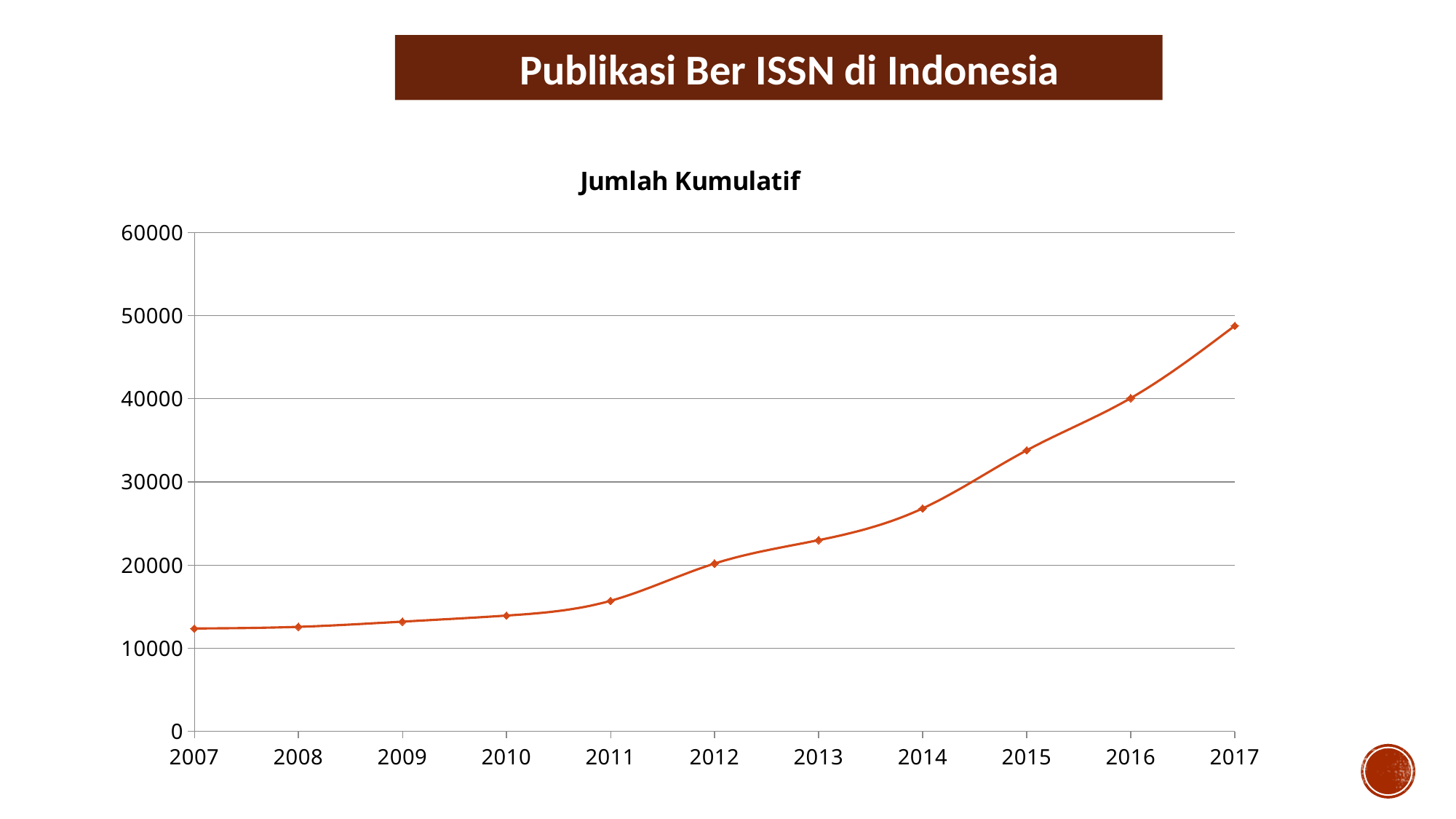
Which year has the highest value? 2017 Is the value for 2017 greater or less than 50000? less What kind of chart is shown on the slide? line chart How many years are plotted on the x axis? 11 Is the value for 2015 greater or less than 30000? greater Is the value for 2007 greater or less than 10000? greater Which is larger, the value for 2013 or the value for 2015? 2015 What is the title of the chart? Jumlah Kumulatif Do the values rise or fall from 2007 to 2017? rise